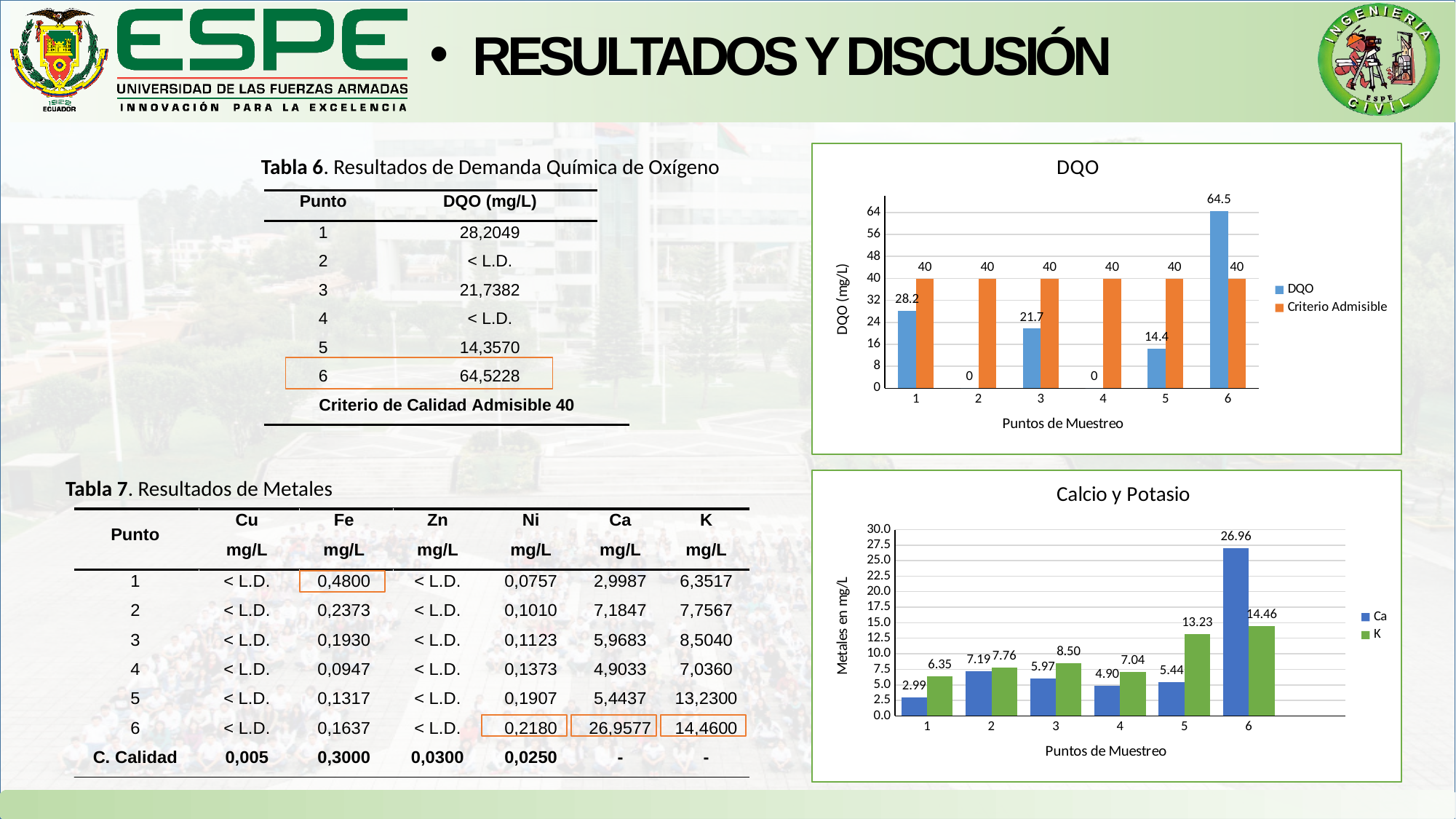
In the DQO chart, what is the DQO value at sampling point 3? 21.7 In the Calcio y Potasio chart, what is the difference between the K value and the Ca value at sampling point 1? 3.36 In the DQO chart, what is the difference between the DQO value at point 6 and the Criterio Admisible value at point 6? 24.5 In the Calcio y Potasio chart, what is the K value at sampling point 5? 13.23 In the Calcio y Potasio chart, how many sampling points are shown on the x axis? 6 In the DQO chart, which sampling point has the highest DQO value? 6 In the DQO chart, how many series does the legend list? 2 In the DQO chart, is the DQO value at point 1 larger or smaller than the Criterio Admisible value at point 1? smaller What type of chart is the Calcio y Potasio chart? bar chart In the DQO chart, what is the DQO value at sampling point 6? 64.5 In the Calcio y Potasio chart, which sampling point has the lowest Ca value? 1 In the Calcio y Potasio chart, what is the Ca value at sampling point 6? 26.96